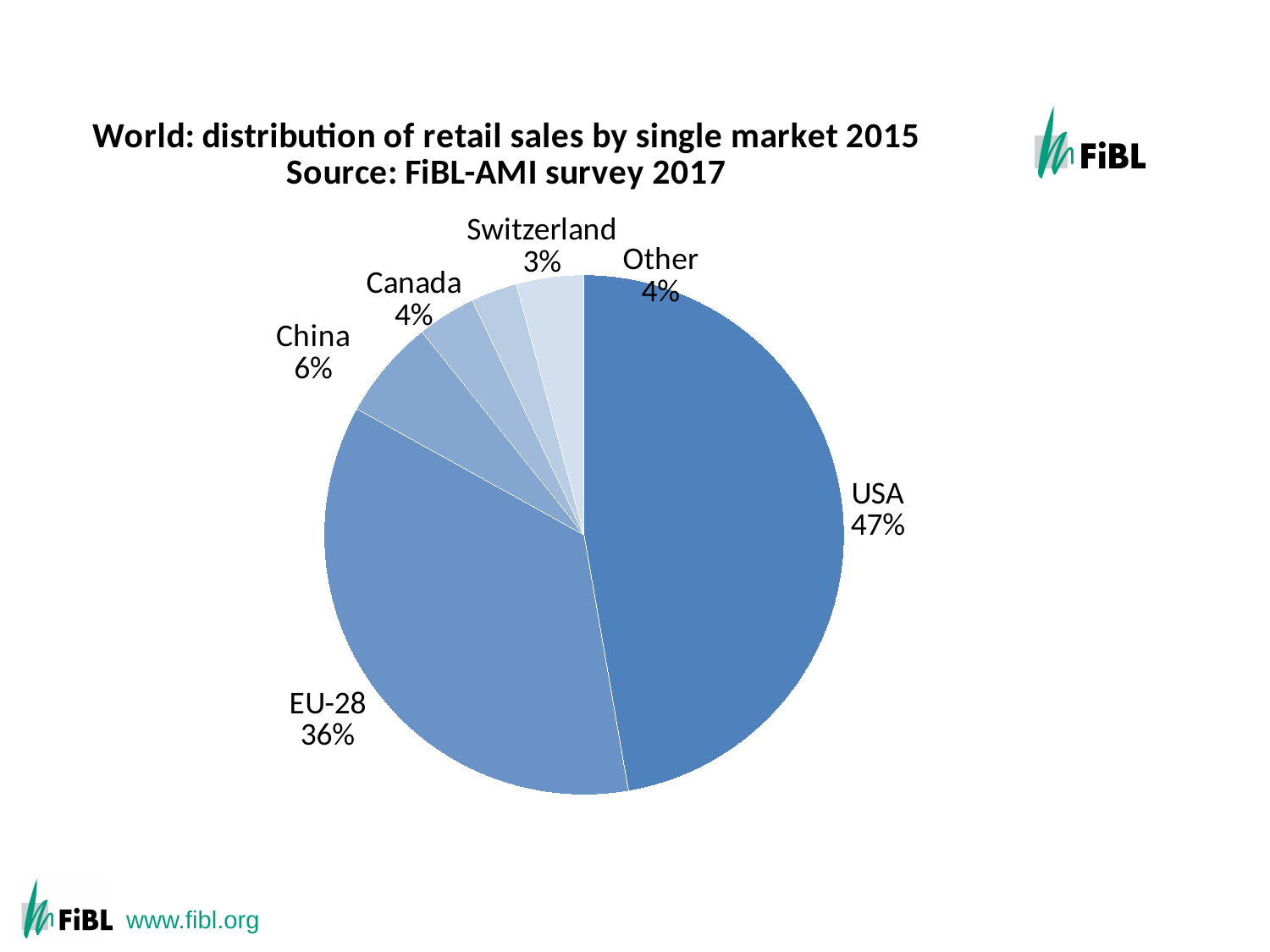
What kind of chart is shown on the slide? Pie chart What is the title of the chart? World: distribution of retail sales by single market 2015 What share of retail sales does the USA hold? 47% What is the difference in percentage points between the USA and EU-28 shares? 11 What share of retail sales does the EU-28 hold? 36% What is the combined share of the USA and EU-28? 83% What share of retail sales does China hold? 6% Which market has the smallest share of retail sales? Switzerland Which has a larger share of retail sales, China or Canada? China Which market has the largest share of retail sales? USA How many slices does the pie chart have? 6 What share of retail sales does Switzerland hold? 3%